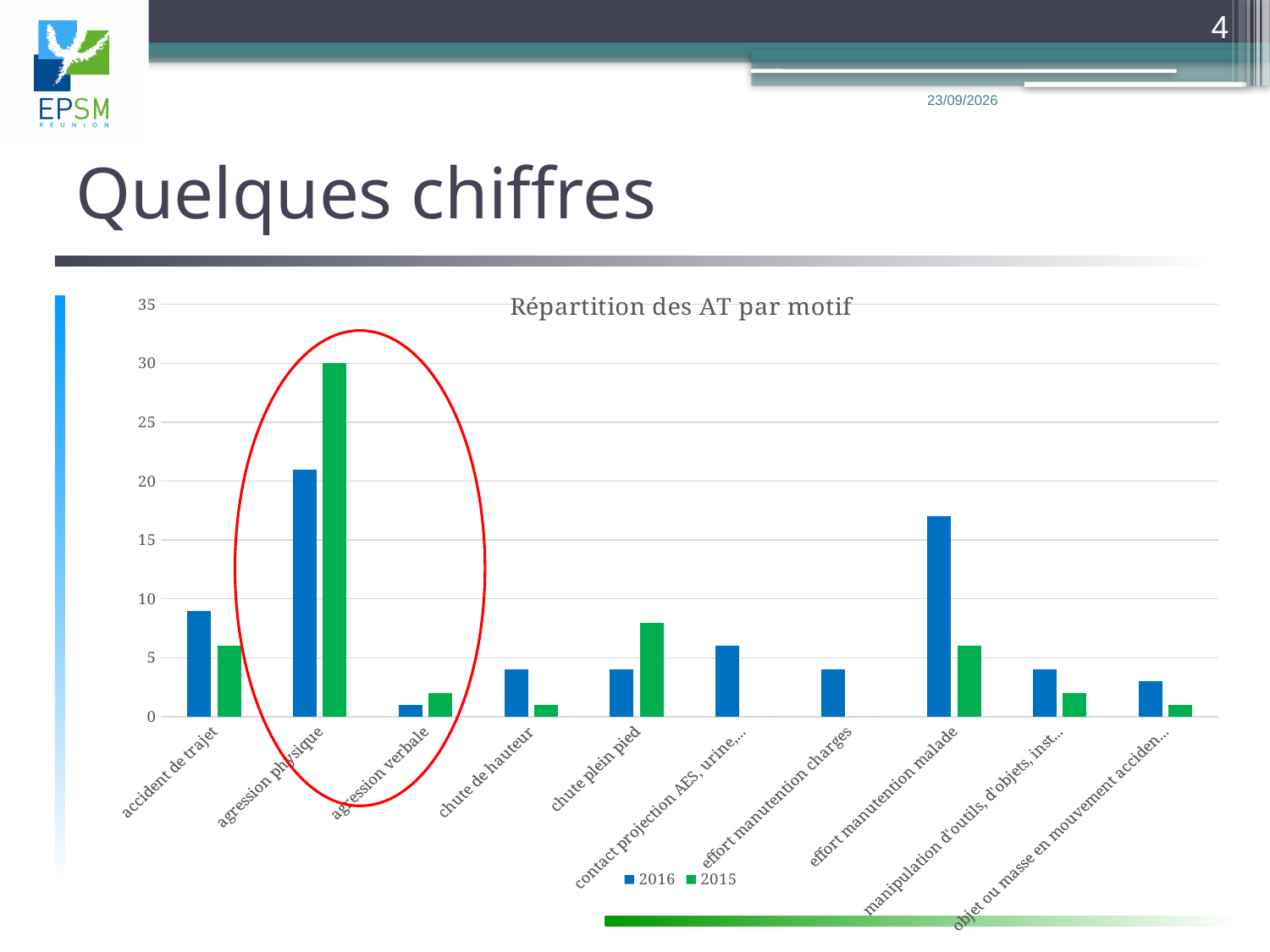
How many categories are shown on the x axis of the chart? 10 How many series does the legend list? 2 Which category has the highest 2016 value? agression physique What is the title of the chart? Répartition des AT par motif What kind of chart is shown on the slide? bar chart Which colour represents the 2015 series in the legend? green Which category has the highest 2015 value? agression physique Is the 2016 value for effort manutention malade greater or less than 15? greater What is the 2015 value for agression physique? 30 For effort manutention malade, which year has the larger value, 2016 or 2015? 2016 Which category has the lowest 2016 value? agression verbale For agression physique, which year has the larger value, 2016 or 2015? 2015